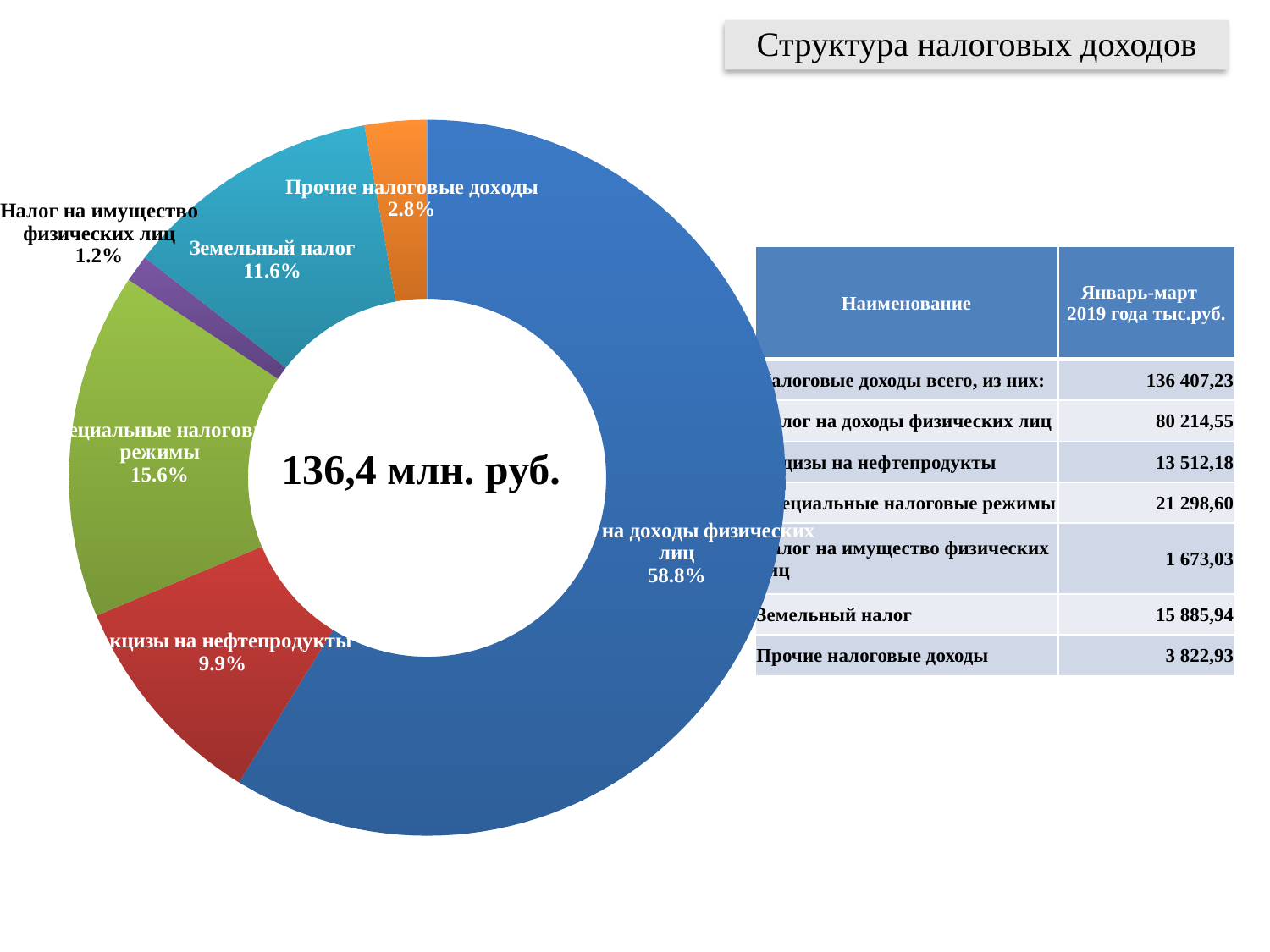
What share of the doughnut chart does Прочие налоговые доходы account for? 2.8% What total value is printed in the centre of the doughnut chart? 136,4 млн. руб. Which slice is larger in the doughnut chart: Земельный налог or Акцизы на нефтепродукты? Земельный налог What share of the doughnut chart does Акцизы на нефтепродукты account for? 9.9% Which category has the smallest slice in the doughnut chart? Налог на имущество физических лиц How many slices does the doughnut chart have? 6 What share of the doughnut chart does Налог на имущество физических лиц account for? 1.2% What kind of chart is shown on the slide? Doughnut (pie) chart What is the difference in percentage points between the Специальные налоговые режимы slice and the Земельный налог slice? 4.0 percentage points Which category has the largest slice in the doughnut chart? Налог на доходы физических лиц